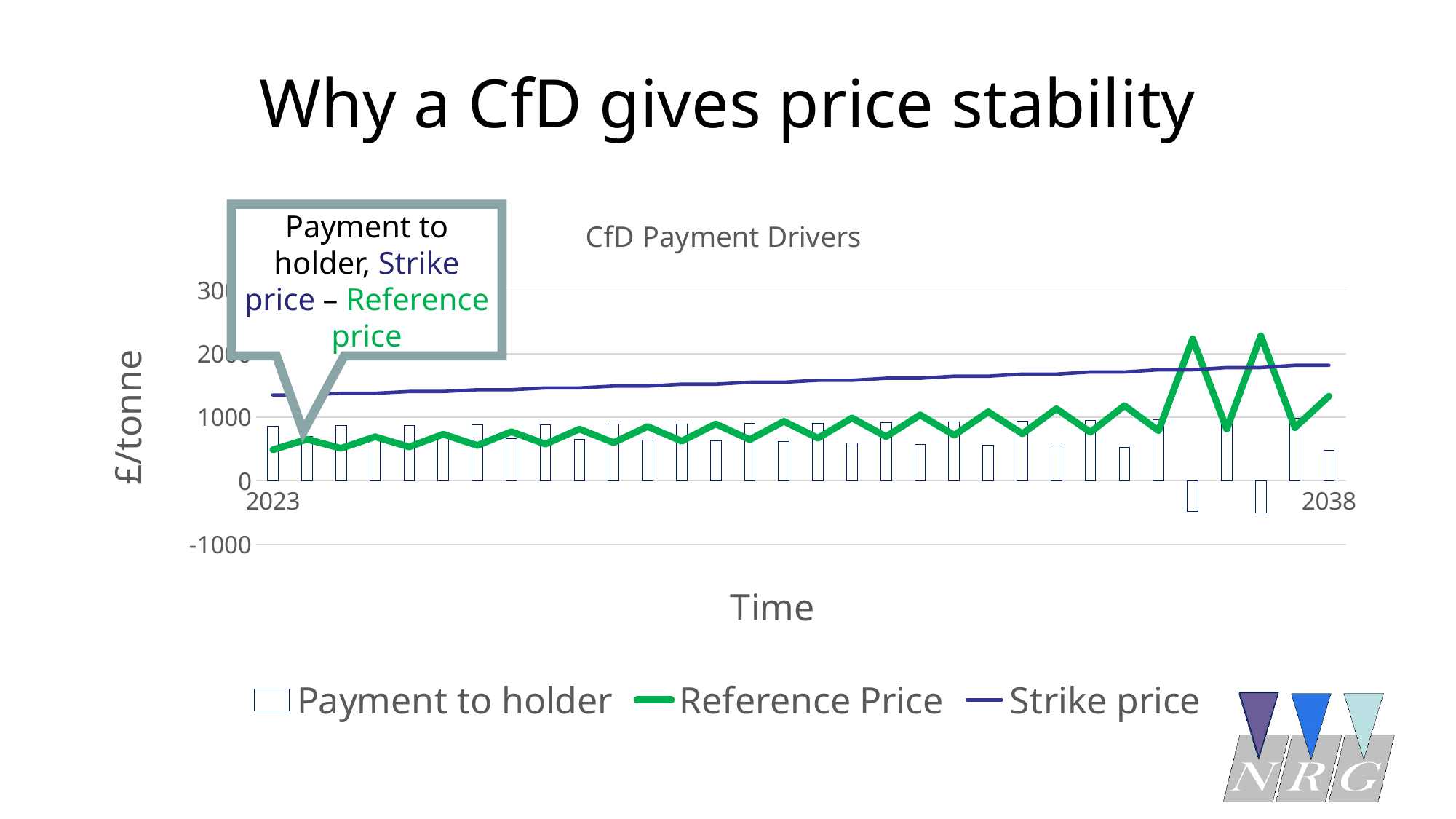
How many series does the chart legend list? 3 Is the Strike price value at 2023 greater or less than 1000? greater Is the Reference Price value at 2023 greater or less than 1000? less What kind of chart is used for the Payment to holder series? Bar chart Is the lowest Payment to holder bar greater or less than 0? less What is the title of the chart? CfD Payment Drivers At 2023, which is larger: the Strike price or the Reference Price? Strike price What kind of chart is used for the Reference Price and Strike price series? Line chart What is the label on the vertical axis? £/tonne Does the Strike price line rise or fall from 2023 to 2038? Rise